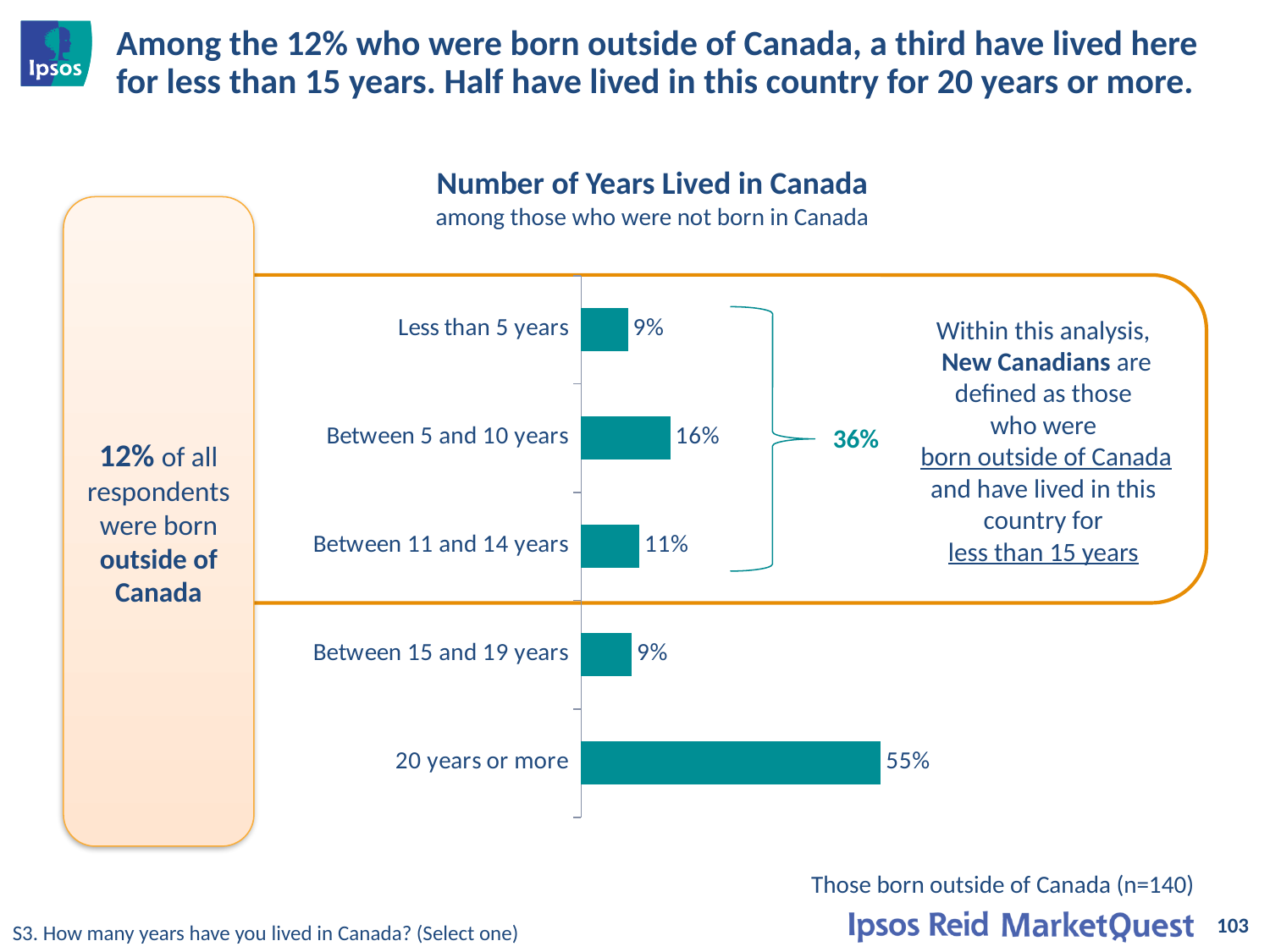
What is the sample size (n) for those born outside of Canada? 140 What is the value for 'Between 11 and 14 years'? 11% Which category has the highest value? 20 years or more What is the combined percentage shown for the three categories under 15 years? 36% What is the difference between the values for '20 years or more' and 'Between 5 and 10 years'? 39% What kind of chart is shown on the slide? Bar chart What is the title of the chart? Number of Years Lived in Canada What is the difference between the values for 'Between 5 and 10 years' and 'Less than 5 years'? 7% What is the value for 'Between 5 and 10 years'? 16% What percentage of respondents not born in Canada have lived in Canada for 20 years or more? 55% Which is larger: the value for 'Between 5 and 10 years' or 'Between 11 and 14 years'? Between 5 and 10 years How many categories are shown in the chart? 5